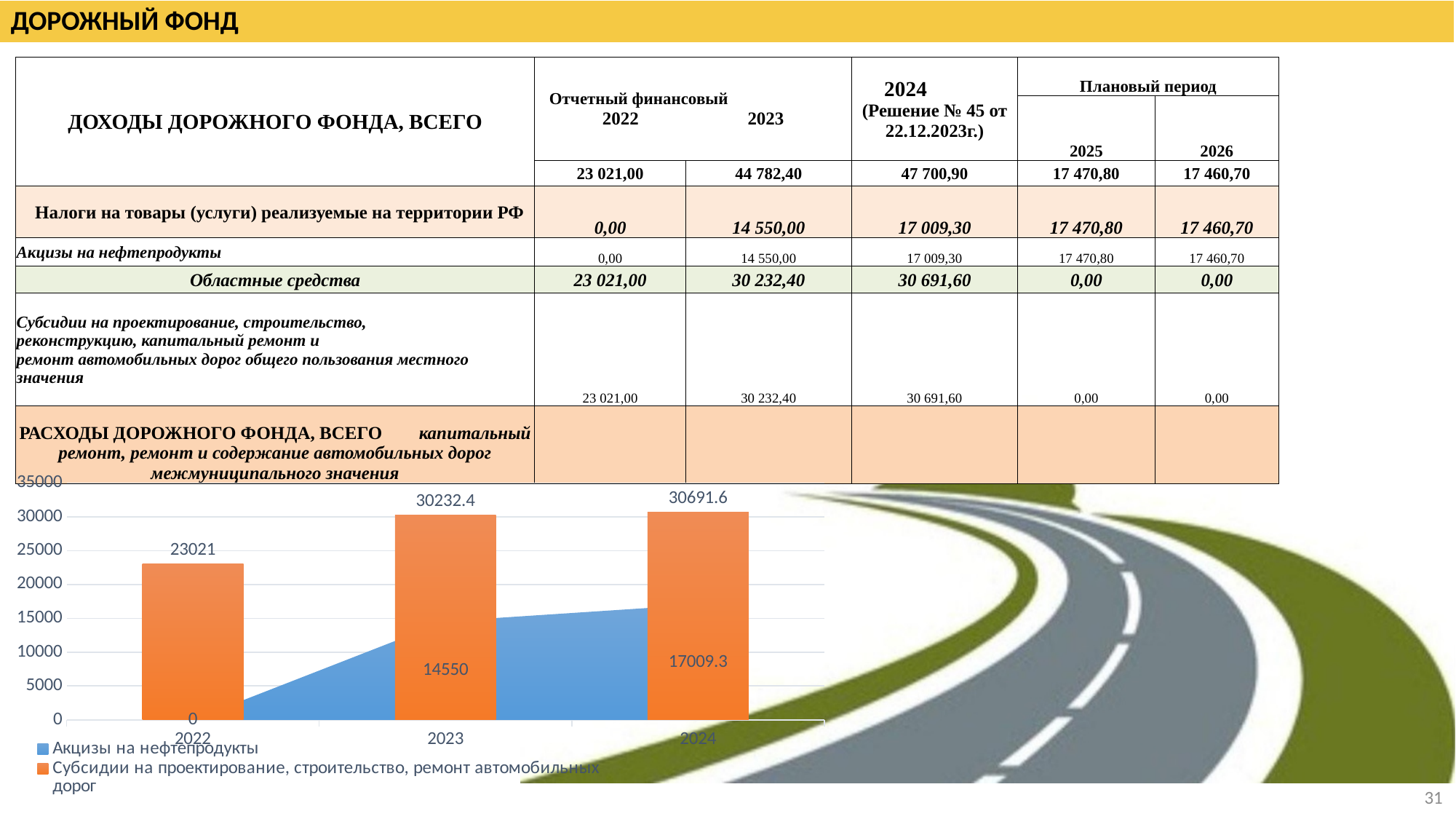
Does the Акцизы на нефтепродукты series rise or fall from 2022 to 2024 in the chart? rise What is the value of the Субсидии series for 2024 in the chart? 30691.6 In which year is the Субсидии series lowest in the chart? 2022 What is the difference between the Субсидии value and the Акцизы на нефтепродукты value for 2024 in the chart? 13682.3 What is the value of the Акцизы на нефтепродукты series for 2023 in the chart? 14550 What is the value of the Акцизы на нефтепродукты series for 2024 in the chart? 17009.3 How many series does the chart legend list? 2 What is the value of the Субсидии на проектирование, строительство, ремонт автомобильных дорог series for 2022 in the chart? 23021 What is the difference between the Субсидии values for 2023 and 2022 in the chart? 7211.4 Which is larger in the chart: the Акцизы на нефтепродукты value for 2023 or for 2024? 2024 In which year is the Акцизы на нефтепродукты series highest in the chart? 2024 How many years are shown on the x axis of the chart? 3